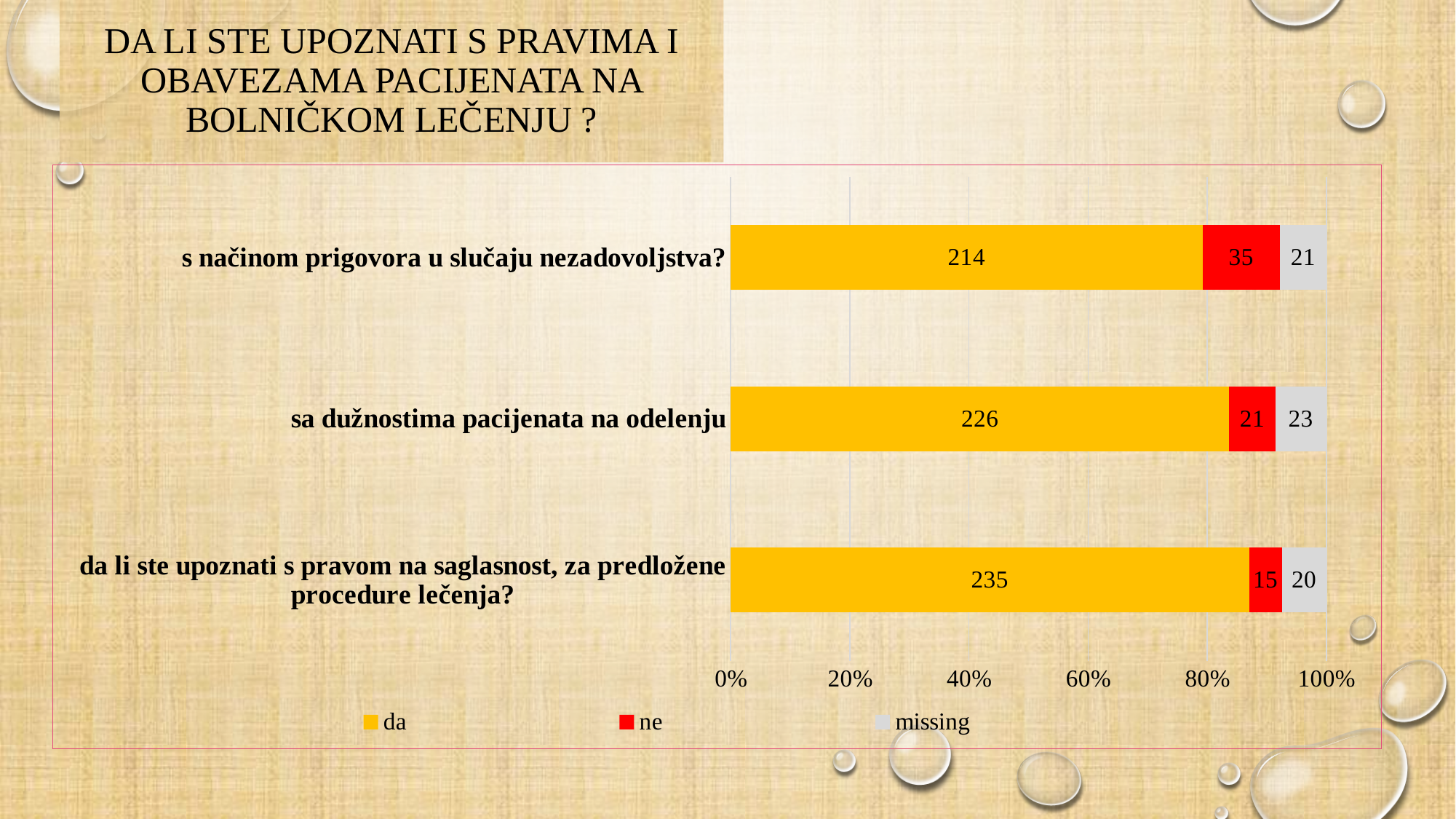
What is the 'da' value for 's načinom prigovora u slučaju nezadovoljstva?'? 214 What is the total of the stacked bar for 'sa dužnostima pacijenata na odelenju'? 270 What kind of chart is shown on the slide? bar chart Which category has the highest 'da' value? da li ste upoznati s pravom na saglasnost, za predložene procedure lečenja? What is the 'missing' value for 'da li ste upoznati s pravom na saglasnost, za predložene procedure lečenja?'? 20 Which colour represents the 'ne' series in the chart? red How many series does the legend list? 3 What is the 'ne' value for 'sa dužnostima pacijenata na odelenju'? 21 How many categories are plotted in the chart? 3 What is the difference between the 'ne' values for 's načinom prigovora u slučaju nezadovoljstva?' and 'sa dužnostima pacijenata na odelenju'? 14 Which is larger: the 'missing' value for 'sa dužnostima pacijenata na odelenju' or for 's načinom prigovora u slučaju nezadovoljstva?'? sa dužnostima pacijenata na odelenju Which category has the lowest 'ne' value? da li ste upoznati s pravom na saglasnost, za predložene procedure lečenja?